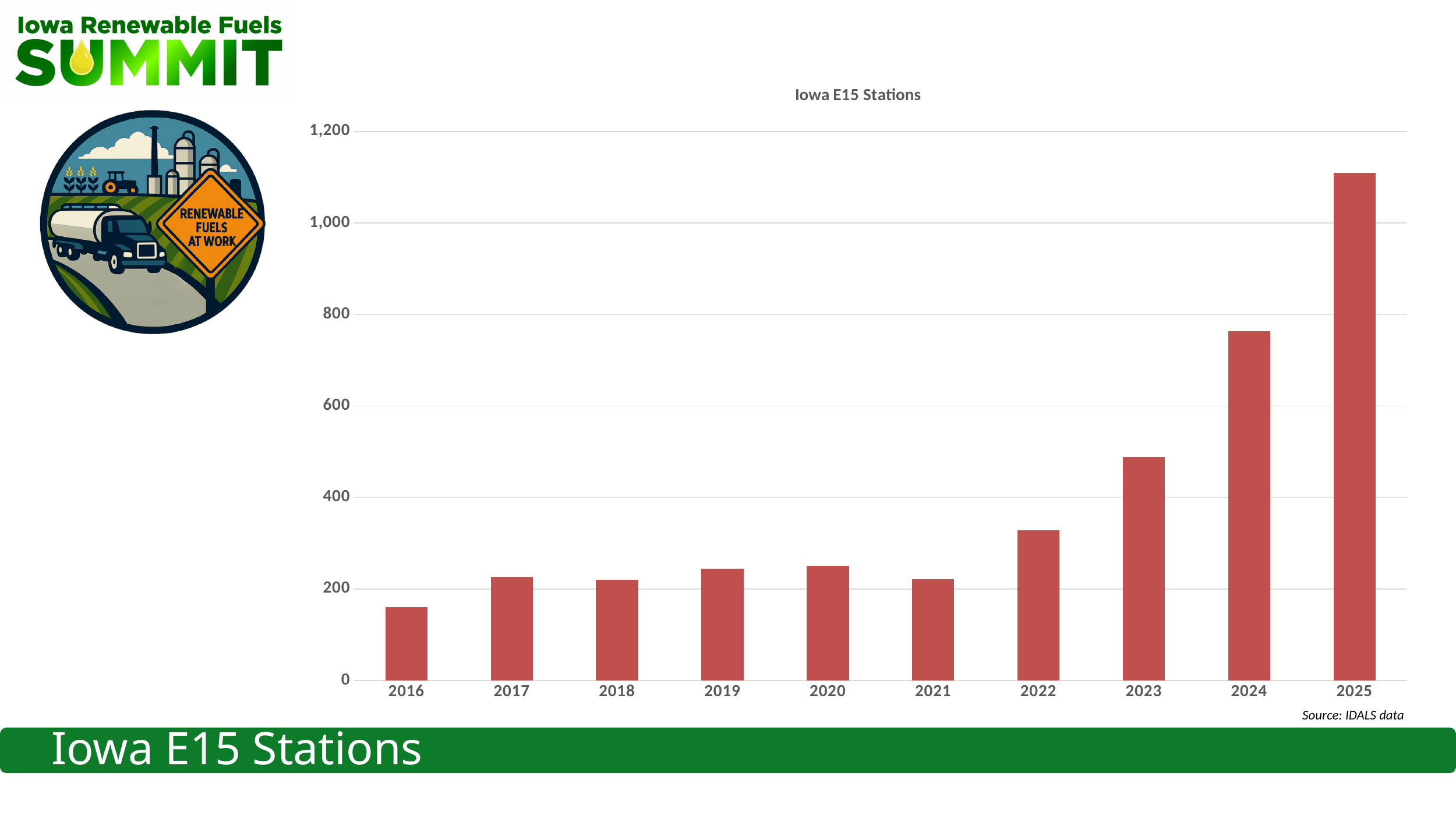
Do the values generally rise or fall from 2016 to 2025? Rise What is the title of the chart? Iowa E15 Stations Which year has more Iowa E15 stations, 2023 or 2024? 2024 Is the value for 2016 greater or less than 200? less Is the value for 2025 greater or less than 1,000? greater Which year has the highest number of Iowa E15 stations? 2025 What kind of chart is shown on the slide? Bar chart Is the value for 2023 greater or less than 400? greater How many years are plotted on the x axis of the chart? 10 Which year has the lowest number of Iowa E15 stations? 2016